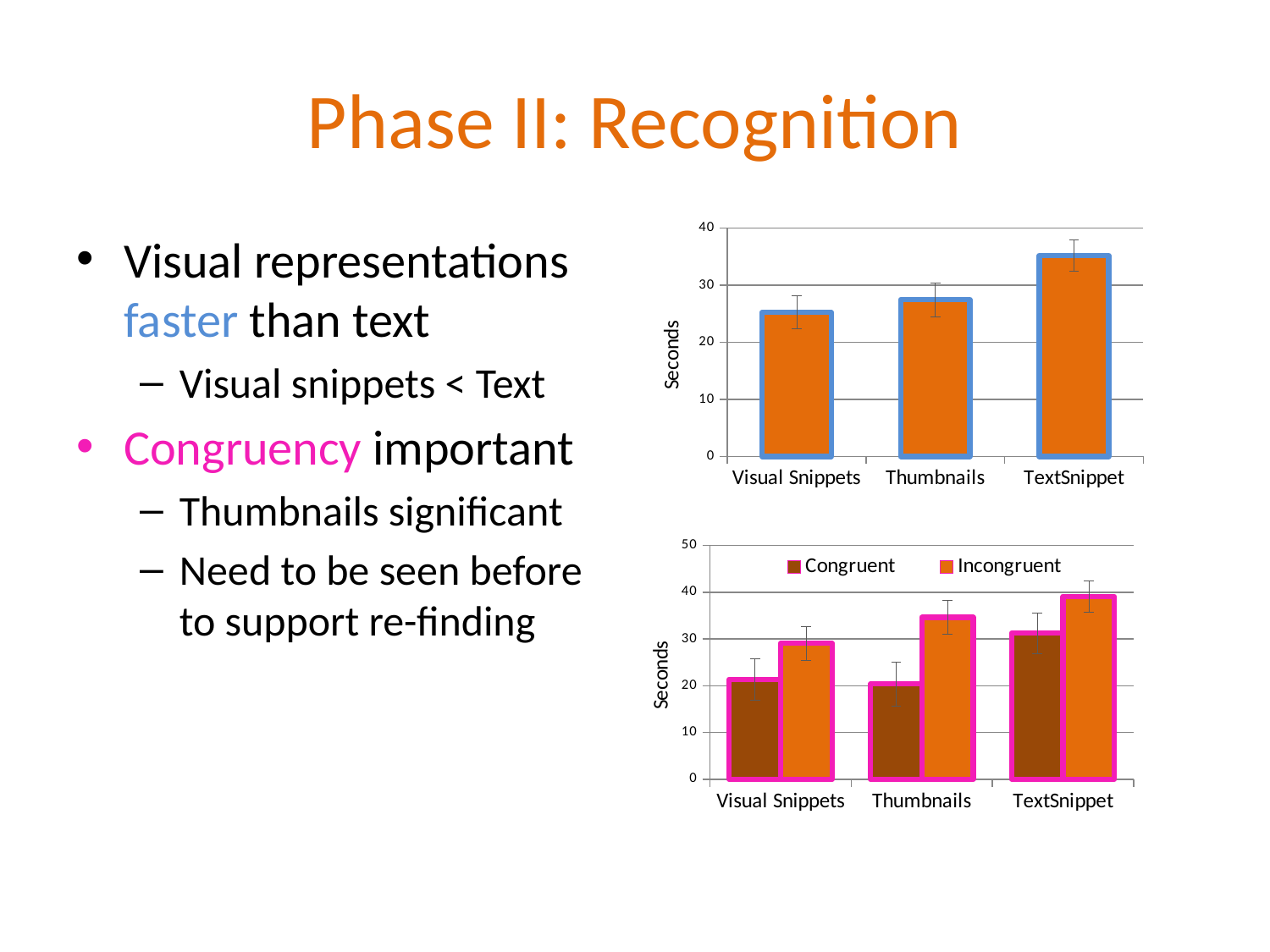
In the top chart, which category has the highest value? TextSnippet In the top chart, is the value for Visual Snippets greater or less than 30? less In the top chart, do the values rise or fall from Visual Snippets to TextSnippet along the x axis? rise In the bottom chart, which category has the lowest Congruent value? Thumbnails How many categories are shown on the x axis of the top chart? 3 In the bottom chart, which category has the highest Incongruent value? TextSnippet In the top chart, is the value for TextSnippet greater or less than 30? greater What are the two series named in the legend of the bottom chart? Congruent and Incongruent What is the y-axis label of the top chart? Seconds How many series does the legend of the bottom chart list? 2 In the bottom chart, for Thumbnails, is the Congruent value or the Incongruent value larger? Incongruent What kind of chart is the top chart on the slide? bar chart